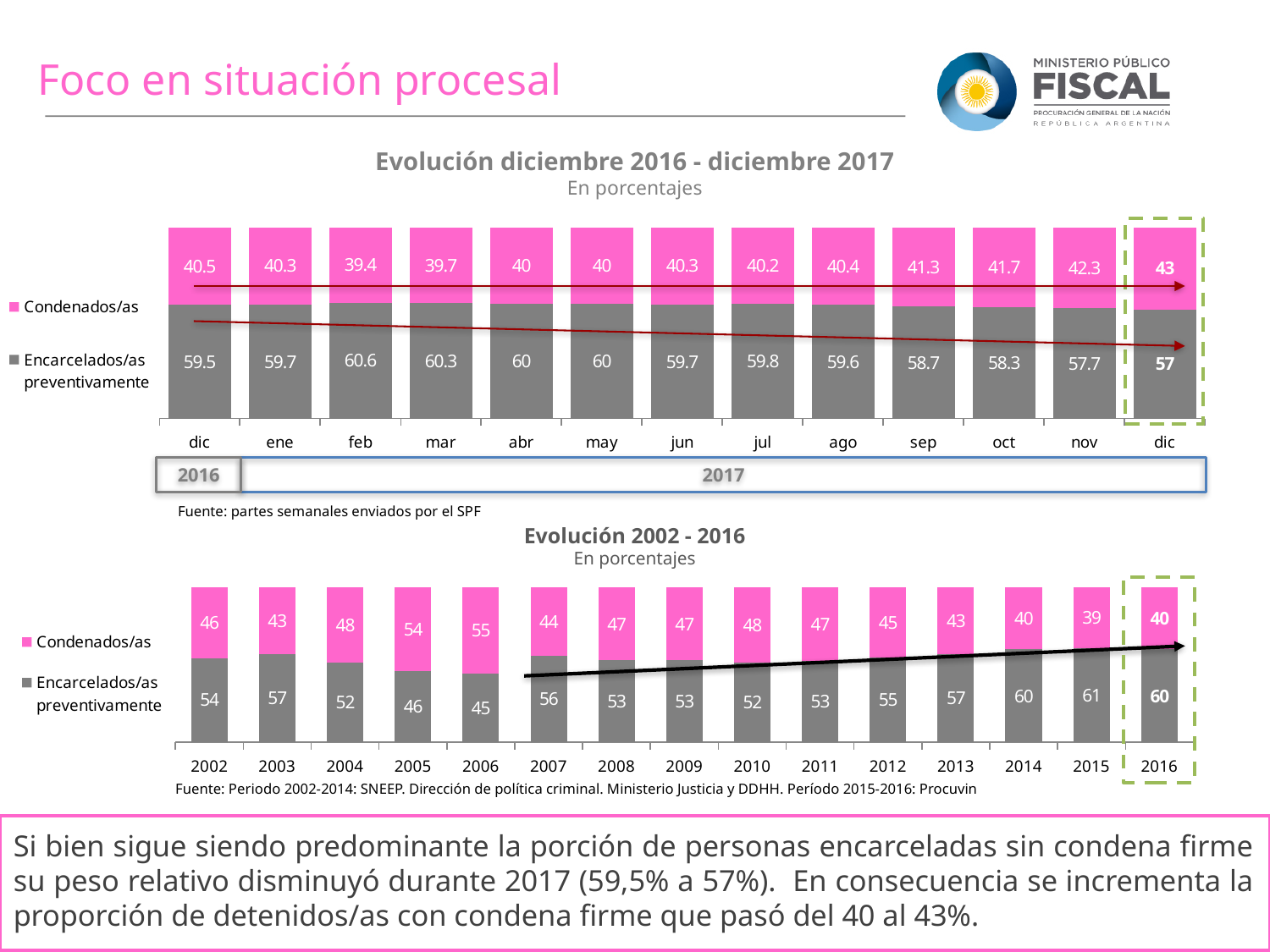
In the chart 'Evolución 2002 - 2016', which year has the highest value for Condenados/as? 2006 In the chart 'Evolución diciembre 2016 - diciembre 2017', what is the difference between the Encarcelados/as preventivamente values for dic 2016 and dic 2017? 2.5 In the chart 'Evolución 2002 - 2016', what is the value for Encarcelados/as preventivamente in 2015? 61 In the chart 'Evolución 2002 - 2016', what is the total of the stacked bar for 2010? 100 In the chart 'Evolución diciembre 2016 - diciembre 2017', does the Condenados/as value rise or fall from sep to dic 2017? rise In the chart 'Evolución diciembre 2016 - diciembre 2017', what is the value for Encarcelados/as preventivamente in feb? 60.6 In the chart 'Evolución diciembre 2016 - diciembre 2017', which month has the highest value for Encarcelados/as preventivamente? feb In the chart 'Evolución diciembre 2016 - diciembre 2017', how many months are shown on the x axis? 13 In the chart 'Evolución diciembre 2016 - diciembre 2017', what is the value for Condenados/as in dic 2017? 43 In the chart 'Evolución 2002 - 2016', which is larger in 2005: Condenados/as or Encarcelados/as preventivamente? Condenados/as In the chart 'Evolución 2002 - 2016', which year has the lowest value for Encarcelados/as preventivamente? 2006 How many series does the legend of the chart 'Evolución 2002 - 2016' list? 2